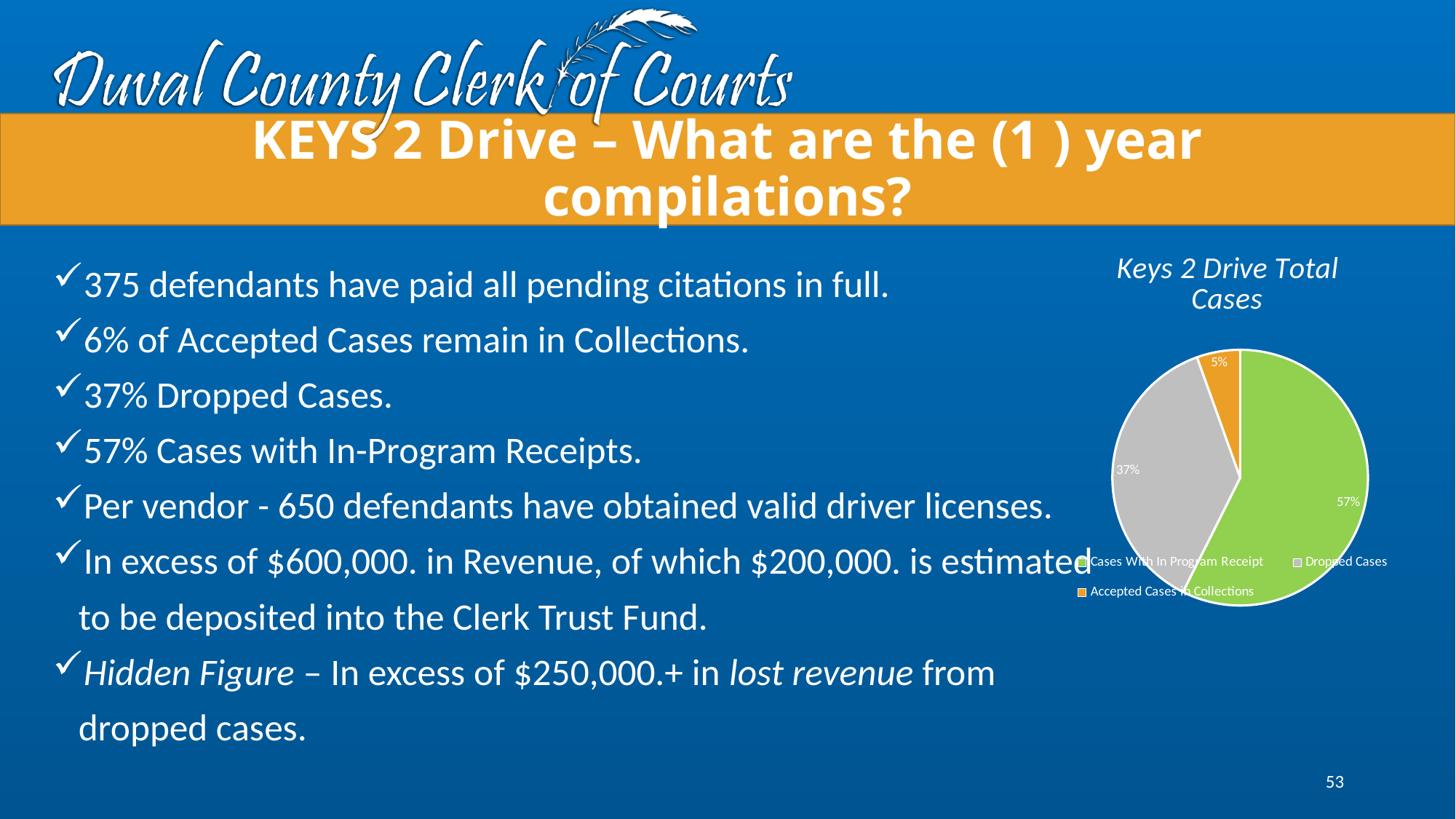
Which is larger, the share for Dropped Cases or the share for Accepted Cases in Collections? Dropped Cases What share of the pie is Accepted Cases in Collections? 5% What is the difference in percentage points between Cases With In Program Receipt and Dropped Cases? 20 What colour is the Dropped Cases slice in the pie chart? gray What is the title of the chart on the slide? Keys 2 Drive Total Cases What share of the pie is Cases With In Program Receipt? 57% How many entries does the chart legend list? 3 How many slices does the pie chart have? 3 Which category has the smallest slice of the pie? Accepted Cases in Collections What share of the pie is Dropped Cases? 37% Which category has the largest slice of the pie? Cases With In Program Receipt What kind of chart is shown on the slide? pie chart